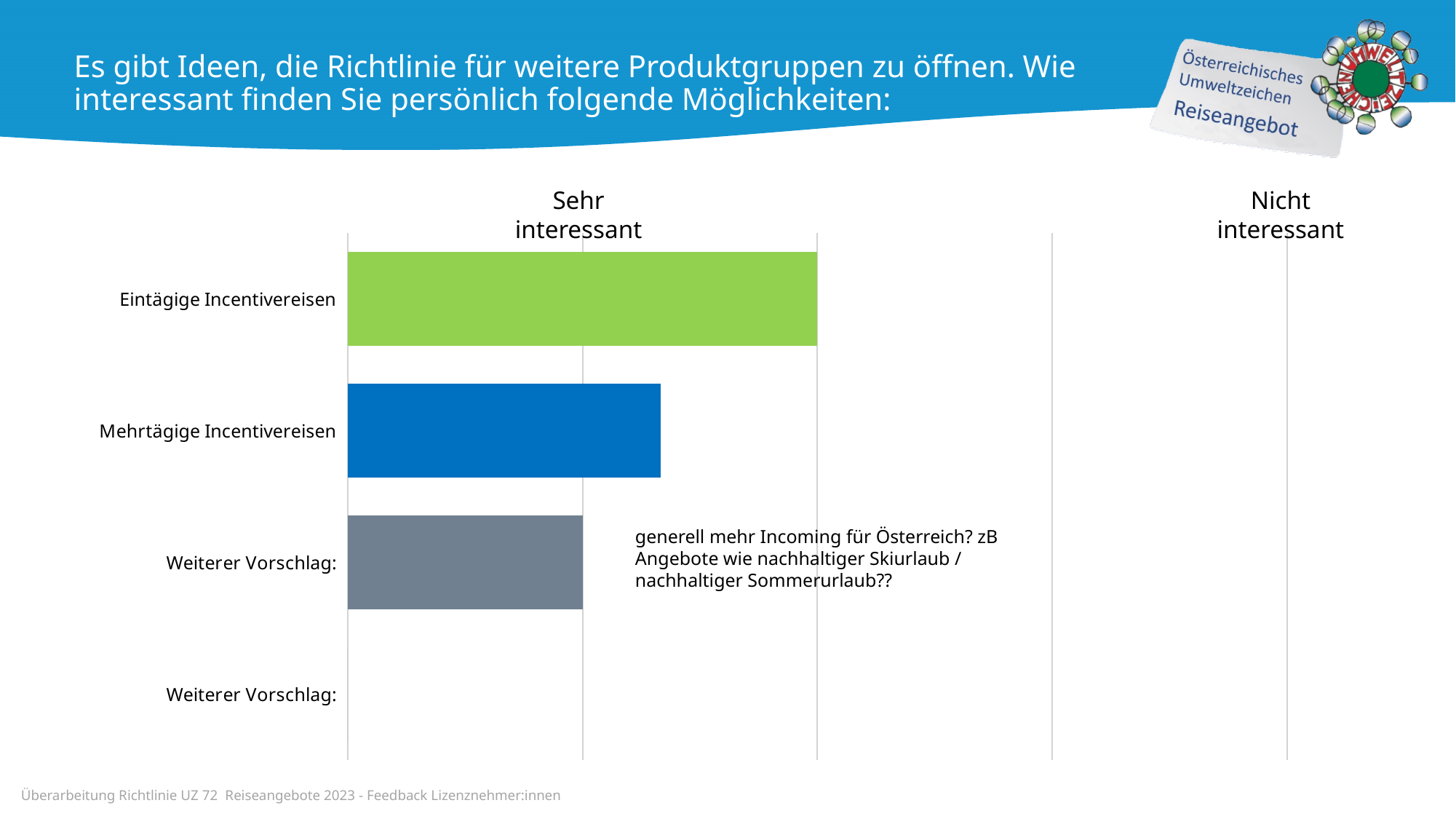
Which bar is longer, Eintägige Incentivereisen or Mehrtägige Incentivereisen? Eintägige Incentivereisen What colour is the bar for Eintägige Incentivereisen? green What label appears at the left end of the chart's horizontal axis? Sehr interessant How many categories are listed on the vertical axis of the chart? 4 Which category has the longest bar in the chart? Eintägige Incentivereisen Do the bar lengths increase or decrease going down the chart from Eintägige Incentivereisen to the last Weiterer Vorschlag? decrease Which bar is longer, Mehrtägige Incentivereisen or the first Weiterer Vorschlag? Mehrtägige Incentivereisen Which category has no bar plotted at all in the chart? the second Weiterer Vorschlag: What kind of chart is shown on the slide? bar chart